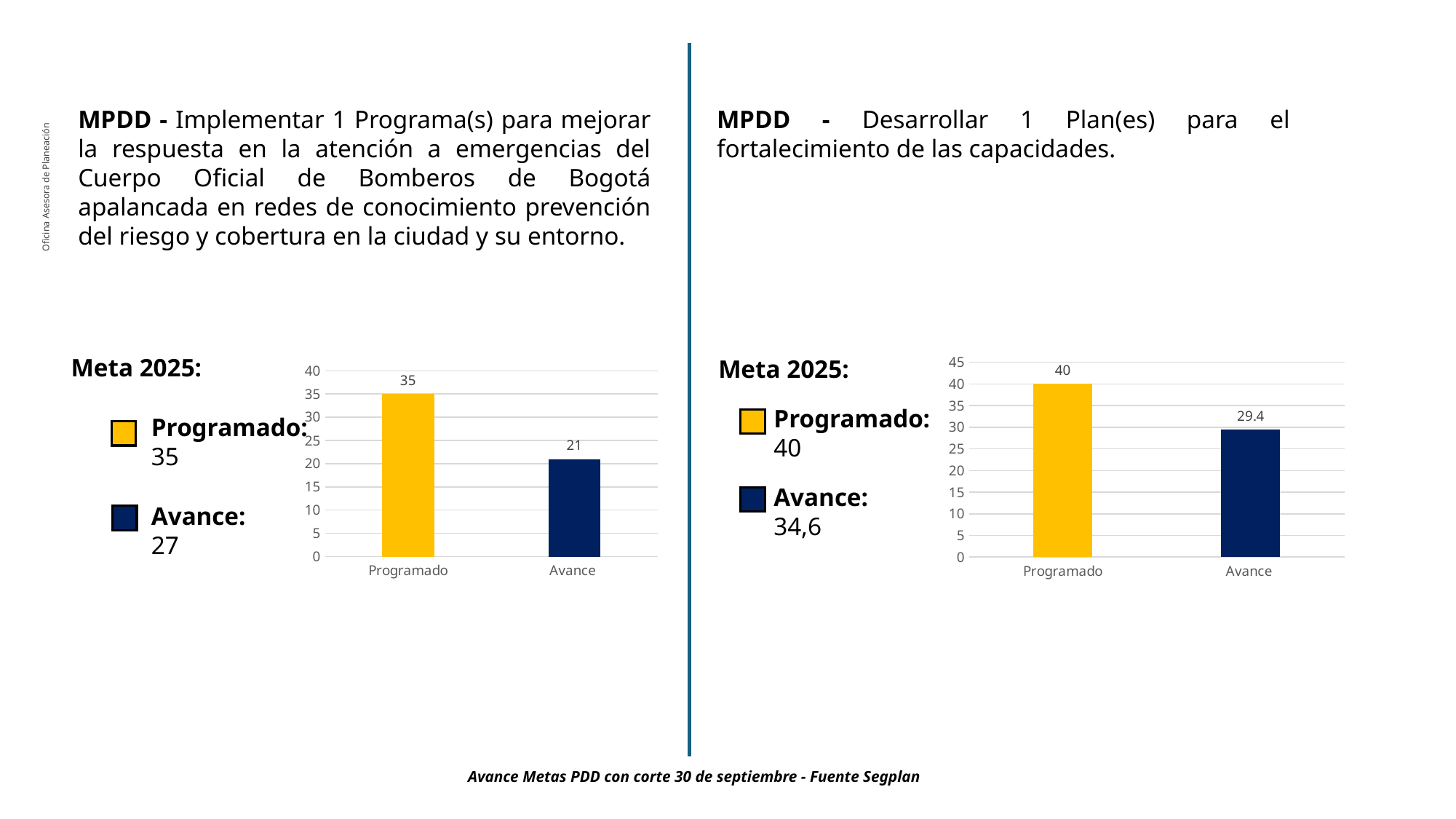
In the left chart, what is the difference between the Programado and Avance values? 14 In the right chart, what is the value of the Avance bar? 29.4 What type of chart is shown on the left side of the slide? Bar chart In the left chart, what is the value of the Avance bar? 21 In the left chart, which bar is higher, Programado or Avance? Programado How many bars does the right chart have? 2 In the left chart, what colour is the Programado bar? Yellow In the right chart, what is the difference between the Programado and Avance values? 10.6 In the right chart, what is the value of the Programado bar? 40 In the right chart, which category has the lowest value? Avance In the left chart, what is the value of the Programado bar? 35 In the right chart, is the value for Avance greater or less than 30? less